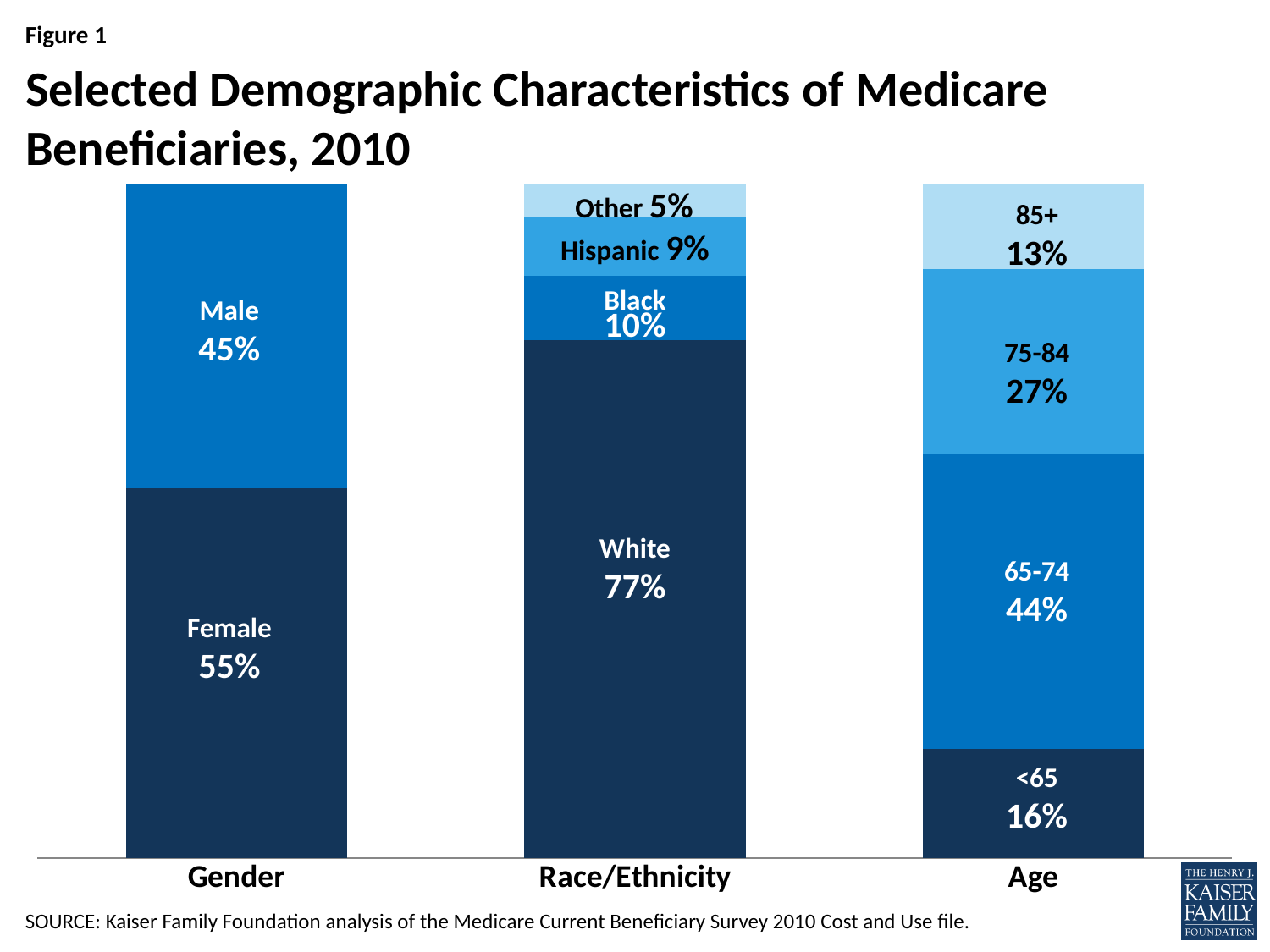
How many segments make up the Race/Ethnicity bar? 4 Which age group has the smallest share of beneficiaries? 85+ Which race/ethnicity group has the largest share of beneficiaries? White What is the difference in percentage points between female and male beneficiaries? 10 Which is larger, the share of beneficiaries aged 65-74 or aged 75-84? 65-74 What share of beneficiaries are aged 85+? 13% What type of chart is shown on the slide? Stacked bar chart What percentage of Medicare beneficiaries are female? 55% What is the title of the chart? Selected Demographic Characteristics of Medicare Beneficiaries, 2010 How many stacked bars are shown in the chart? 3 What percentage of Medicare beneficiaries are Hispanic? 9% What is the combined share of beneficiaries aged 75-84 and 85+? 40%